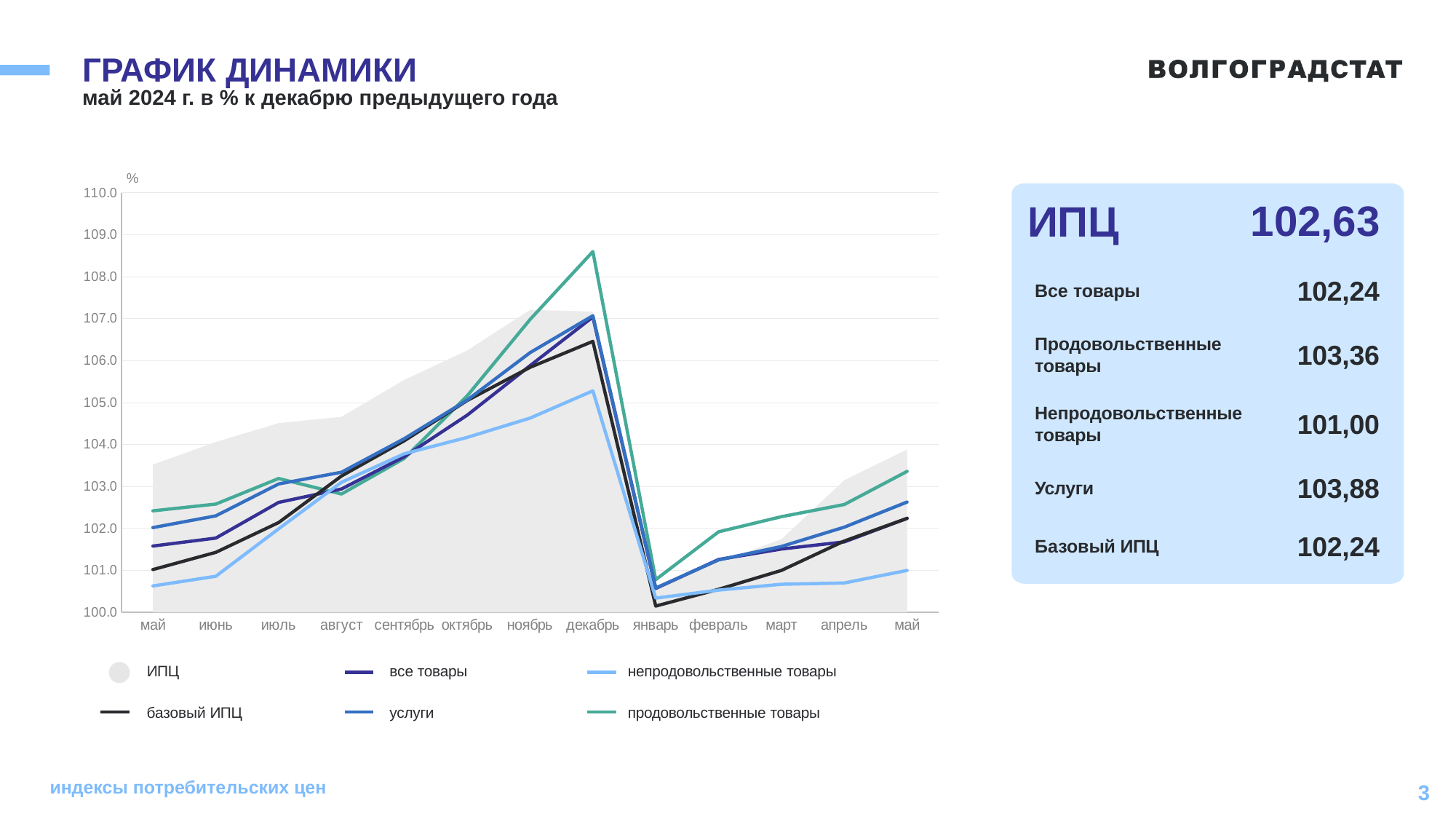
Which series has the lowest value in январь? базовый ИПЦ What is the difference between Услуги (103,88) and Непродовольственные товары (101,00) in май 2024? 2,88 According to the slide, what is the value for Услуги in май 2024? 103,88 According to the slide, what is the value of ИПЦ for май 2024? 102,63 What kind of chart is shown on the slide? line chart Is the value for непродовольственные товары in декабрь greater or less than 106.0? less Is the value for продовольственные товары in декабрь greater or less than 108.0? greater How many months are shown along the x axis of the chart? 13 In май 2024, which is larger: Услуги or Непродовольственные товары? Услуги Which series has the highest value in декабрь? продовольственные товары Do the values rise or fall between декабрь and январь? fall How many series does the chart legend list? 6